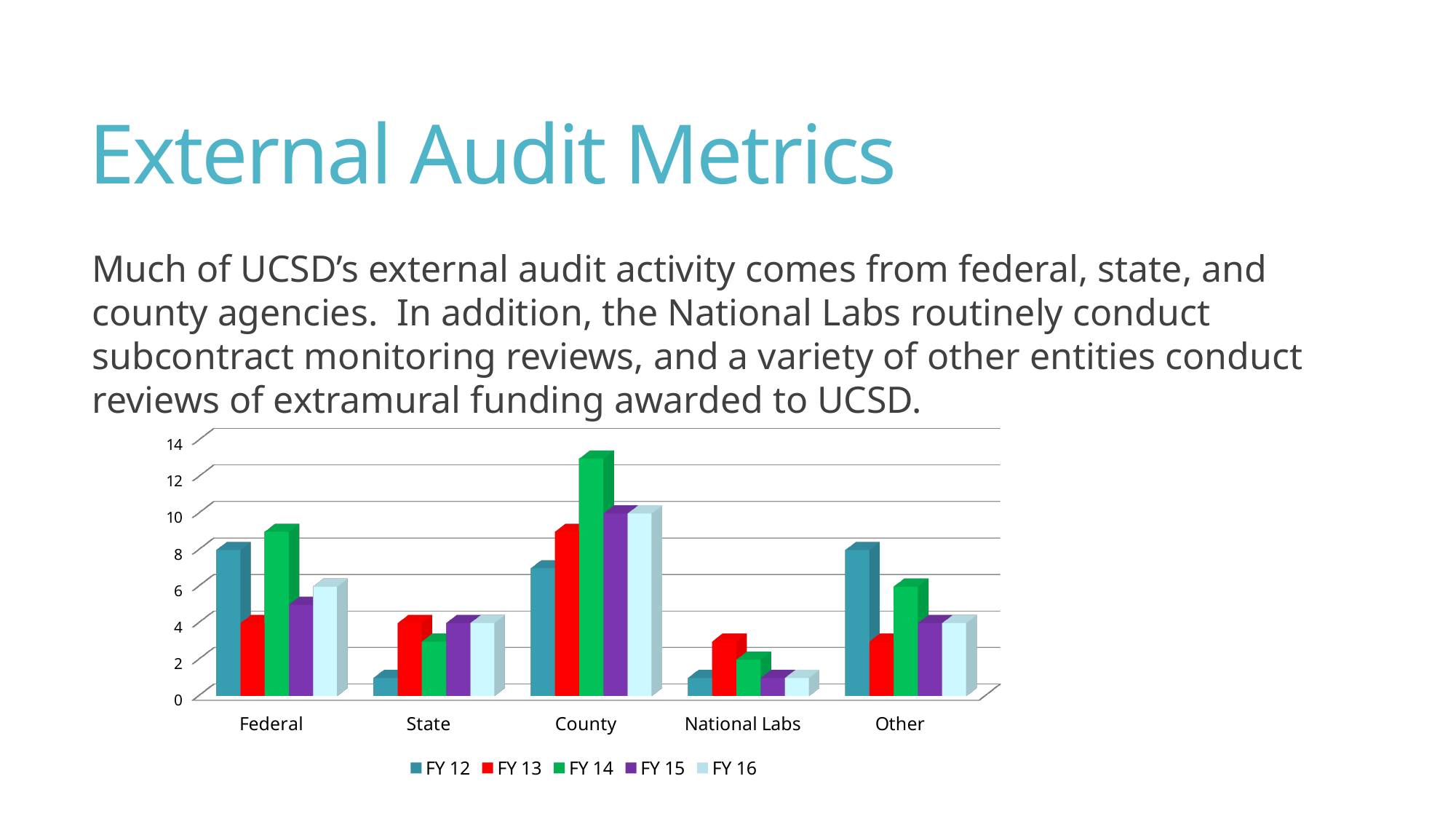
Which is larger for Federal: the FY 12 bar or the FY 13 bar? FY 12 Which category has the highest FY 14 bar? County Is the FY 13 bar for National Labs greater or less than 6? less What kind of chart is shown on the slide? bar chart Which series has the tallest bar in the County category? FY 14 Which category has the lowest FY 16 bar? National Labs Which is larger for FY 14: the County bar or the Federal bar? County How many categories are shown on the x axis? 5 How many series does the legend list? 5 Is the FY 14 bar for County greater or less than 12? greater What is the first entry in the chart legend? FY 12 Is the FY 12 bar for Federal greater or less than 6? greater